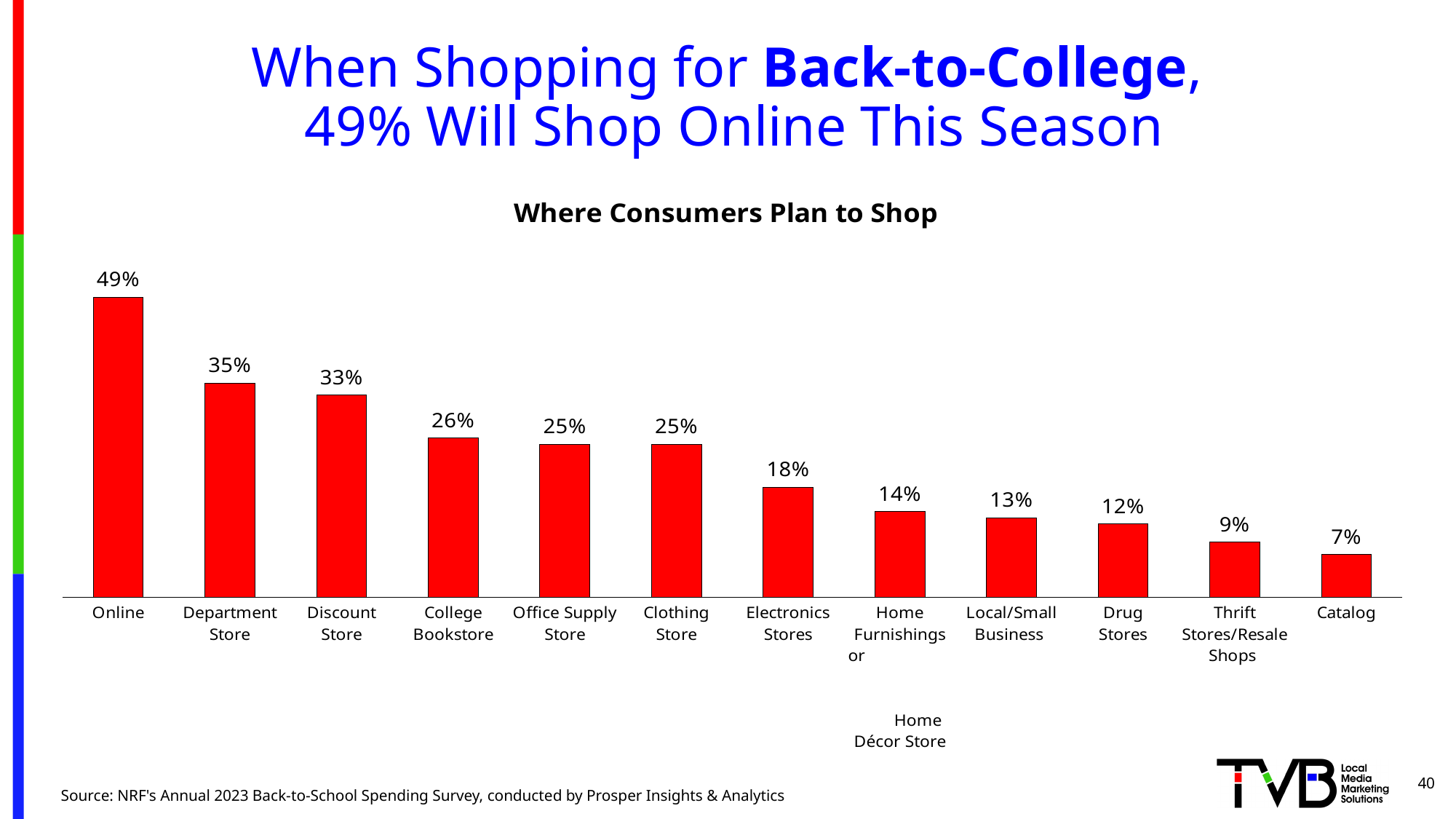
Which category has the lowest value in the chart? Catalog What percentage plan to shop at Drug Stores? 12% What is the difference between the Department Store value and the Catalog value? 28% What percentage of consumers plan to shop at a Department Store? 35% Do the values rise or fall moving from left to right along the x axis? Fall What is the title of the chart? Where Consumers Plan to Shop What is the value shown for Electronics Stores? 18% Which category has the highest value in the chart? Online What is the difference between the Online value and the Discount Store value? 16% How many categories are shown in the chart? 12 What kind of chart is shown on the slide? Bar chart Which is larger, the value for College Bookstore or the value for Electronics Stores? College Bookstore